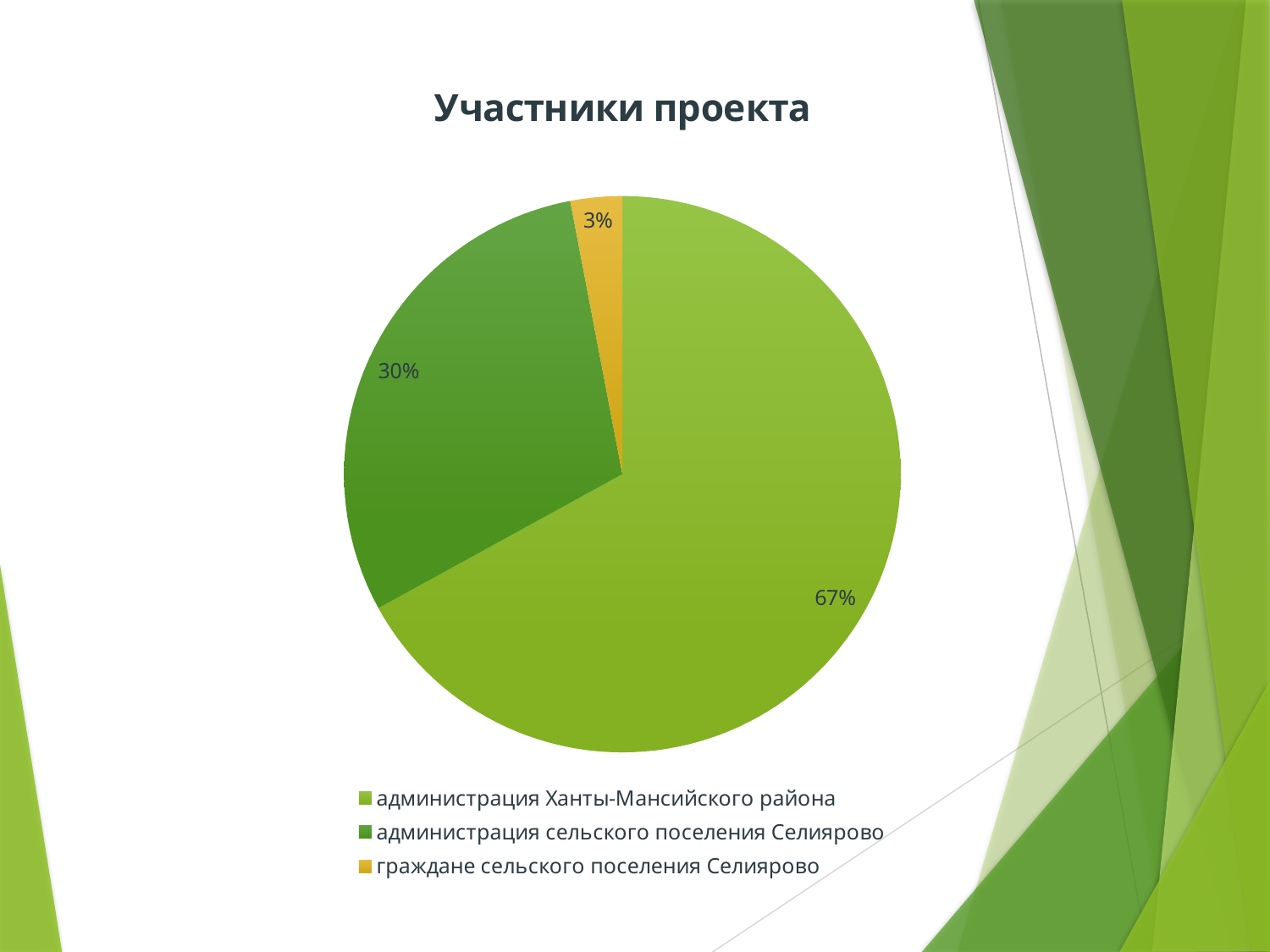
Which category has the largest slice of the pie? администрация Ханты-Мансийского района What is the difference in percentage points between администрация Ханты-Мансийского района and администрация сельского поселения Селиярово? 37 What is the title of the chart? Участники проекта How many categories does the pie chart show? 3 What share of the pie does администрация Ханты-Мансийского района have? 67% What share of the pie does администрация сельского поселения Селиярово have? 30% Which is larger: the slice for администрация сельского поселения Селиярово or the slice for граждане сельского поселения Селиярово? администрация сельского поселения Селиярово Which category has the smallest slice of the pie? граждане сельского поселения Селиярово What share of the pie does граждане сельского поселения Селиярово have? 3% What is the difference in percentage points between администрация сельского поселения Селиярово and граждане сельского поселения Селиярово? 27 What kind of chart is shown on the slide? pie chart What colour is the slice for граждане сельского поселения Селиярово? yellow